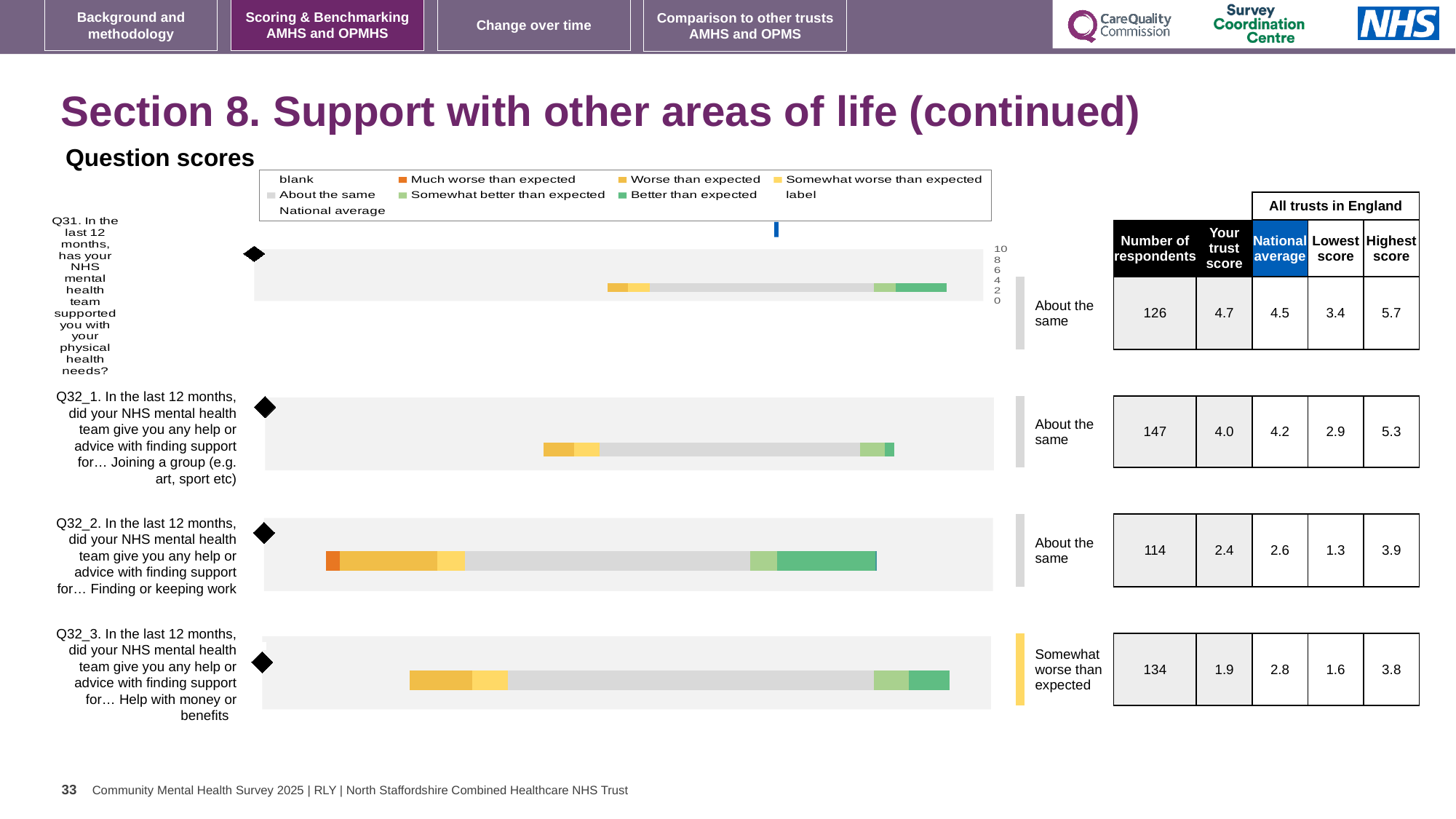
What is the 'Your trust score' value for Q32_2 (Finding or keeping work)? 2.4 What is the difference between the trust score and the national average for Q31? 0.2 How many questions (bars) are shown in the question scores chart? 4 For Q32_1 (Joining a group), which is larger: the trust score or the national average? National average (4.2) What is the national average score for Q32_3 (Help with money or benefits)? 2.8 What kind of chart is used to show the question scores on this slide? Bar chart Which question has the highest 'Your trust score'? Q31 (4.7) For Q32_1 (Joining a group), what is the difference between the highest score and the lowest score across all trusts in England? 2.4 What benchmark label is shown next to the bar for Q32_3 (Help with money or benefits)? Somewhat worse than expected Which question has the lowest 'Your trust score'? Q32_3 (1.9) What is the lowest score across all trusts in England for Q32_2 (Finding or keeping work)? 1.3 How many respondents are listed for Q31 (support with physical health needs)? 126